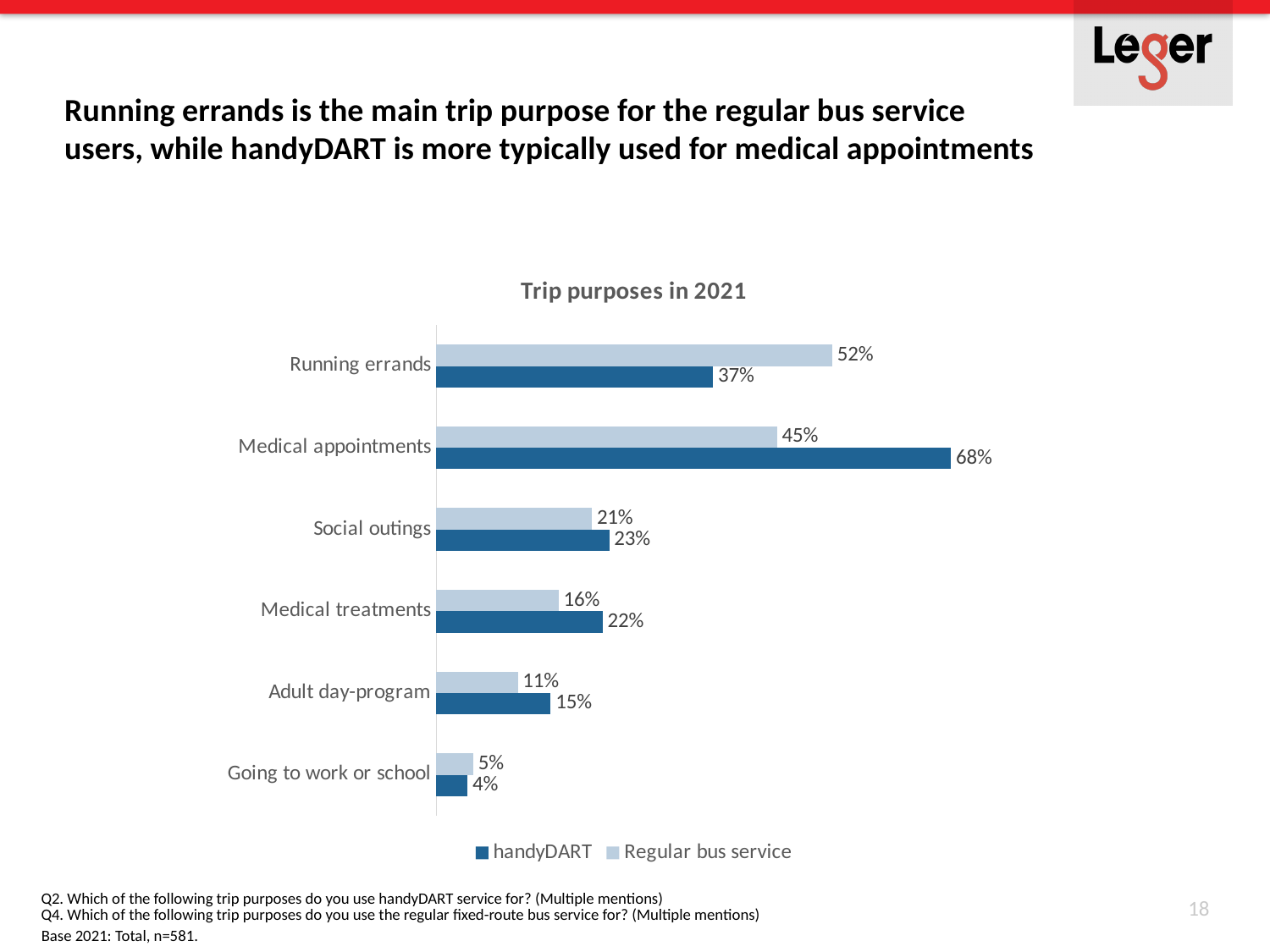
What is the handyDART value for Medical appointments? 68% What kind of chart is shown on the slide? Bar chart What is the handyDART value for Adult day-program? 15% What is the title of the chart? Trip purposes in 2021 What is the difference between the Regular bus service values for Running errands and Medical appointments? 7% Which is larger for Running errands: the handyDART value or the Regular bus service value? Regular bus service Which trip purpose has the lowest Regular bus service value? Going to work or school Which trip purpose has the highest handyDART value? Medical appointments How many series does the legend list? 2 What is the Regular bus service value for Running errands? 52% What is the difference between the handyDART and Regular bus service values for Medical appointments? 23% How many trip purposes are shown in the chart? 6